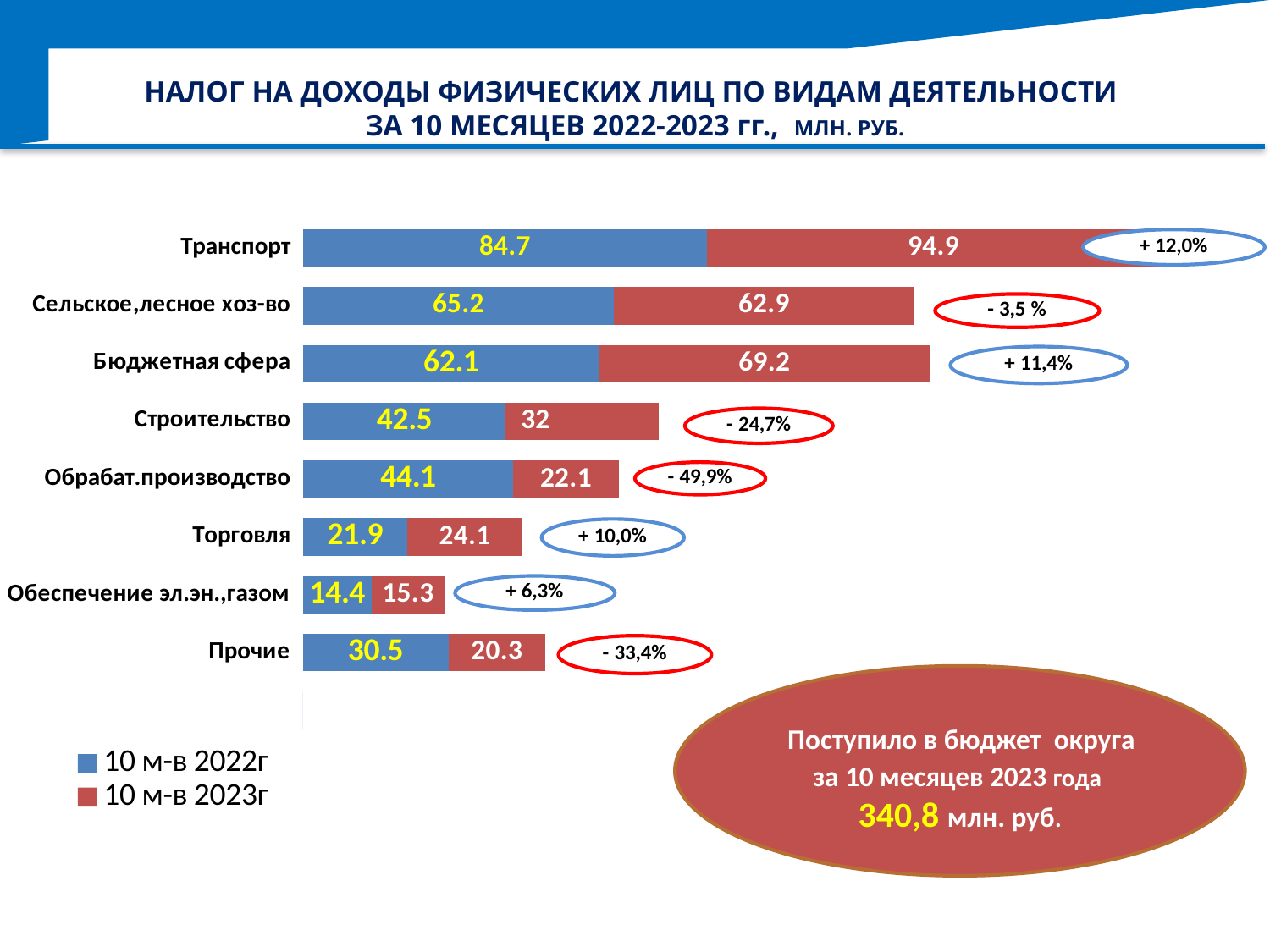
Which category has the lowest value in the 10 м-в 2022г series? Обеспечение эл.эн.,газом Which category has the highest value in the 10 м-в 2023г series? Транспорт What is the difference between the 10 м-в 2023г and 10 м-в 2022г values for Транспорт? 10.2 What is the difference between the 10 м-в 2022г and 10 м-в 2023г values for Обрабат.производство? 22 How many series does the legend list? 2 Which is larger for Строительство: the 10 м-в 2022г value or the 10 м-в 2023г value? 10 м-в 2022г What is the value for Бюджетная сфера in the 10 м-в 2023г series? 69.2 What is the value for Транспорт in the 10 м-в 2022г series? 84.7 What is the total of the stacked bar for Строительство? 74.5 How many categories are shown in the chart? 8 What kind of chart is shown on the slide? Stacked bar chart What is the value for Обеспечение эл.эн.,газом in the 10 м-в 2023г series? 15.3